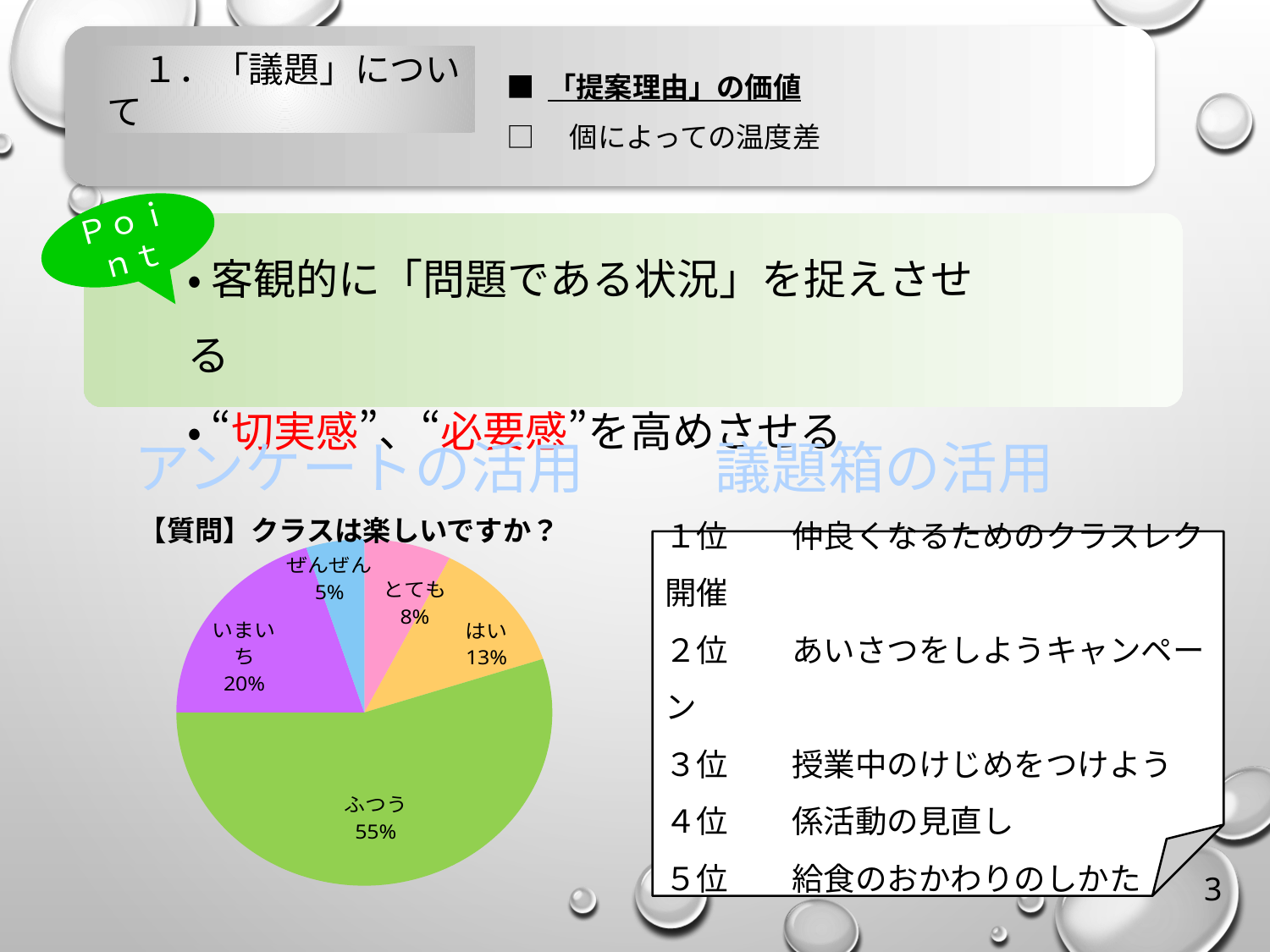
What percentage is shown for ぜんぜん in the pie chart? 5% Which category has the smallest share of the pie chart? ぜんぜん What percentage is shown for いまいち in the pie chart? 20% What is the difference in percentage points between ふつう and いまいち? 35 What percentage is shown for とても in the pie chart? 8% Which category has the largest share of the pie chart? ふつう What kind of chart is shown on the slide? pie chart What is the combined share of とても and はい in the pie chart? 21% Which is larger in the pie chart, はい or とても? はい What is the title of the pie chart? 【質問】クラスは楽しいですか？ What percentage is shown for ふつう in the pie chart? 55% How many slices does the pie chart have? 5